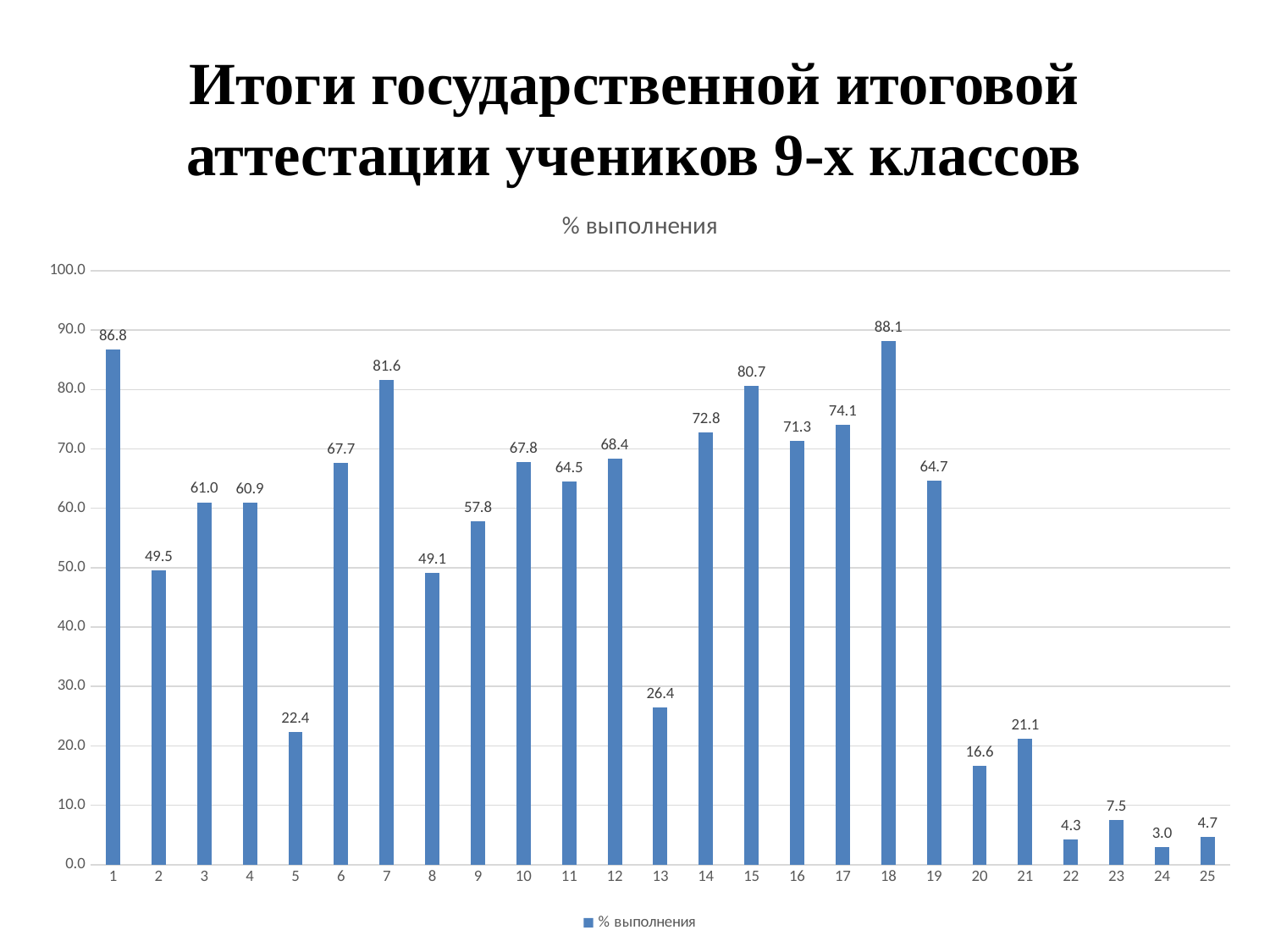
What is the difference between the values for category 18 and category 1? 1.3 How many categories are shown on the x axis? 25 What is the title of the chart? % выполнения What kind of chart is shown on the slide? bar chart How many series does the legend list? 1 Which category has the highest value? 18 Which category has the lowest value? 24 What is the value for category 7? 81.6 Which is larger, the value for category 3 or category 4? category 3 Is the value for category 14 greater or less than 70.0? greater What is the difference between the values for category 14 and category 13? 46.4 What is the value for category 20? 16.6